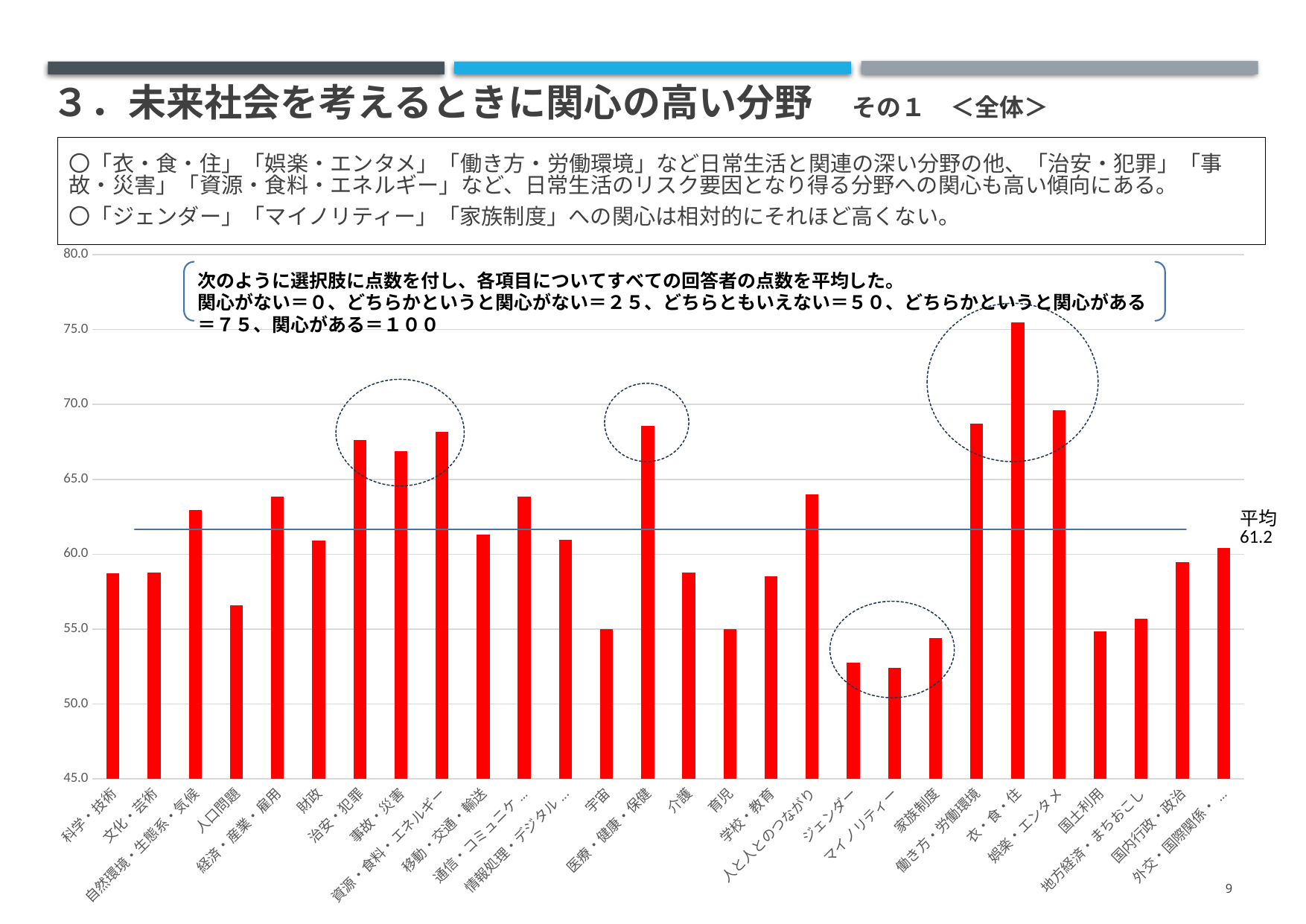
Is the value for 娯楽・エンタメ greater or less than 65? greater Is the value for 衣・食・住 greater or less than 70? greater Which is larger, the value for 治安・犯罪 or the value for 宇宙? 治安・犯罪 Is the value for 宇宙 greater or less than 60? less How many categories (bars) are plotted in the chart? 28 Which category has the highest bar in the chart? 衣・食・住 What kind of chart is shown on the slide? bar chart What is the value of the average (平均) line shown on the chart? 61.2 Which is larger, the value for 衣・食・住 or the value for 娯楽・エンタメ? 衣・食・住 What colour are the bars in the chart? red